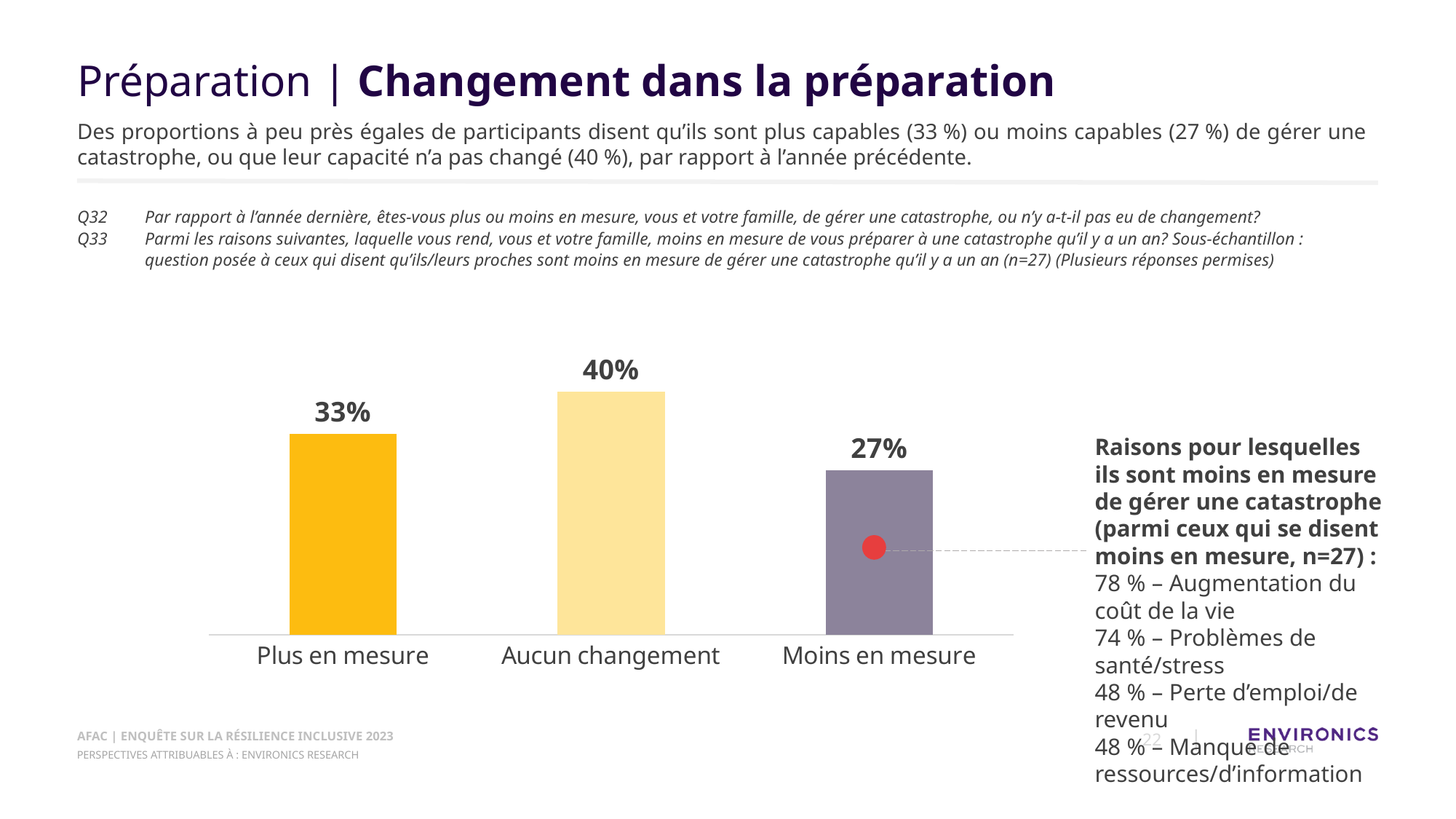
What colour is the bar for "Moins en mesure"? Purple/grey What kind of chart is shown on the slide? Bar chart What is the value for "Moins en mesure"? 27% Which category has the highest value? Aucun changement What is the difference between "Plus en mesure" and "Moins en mesure"? 6% Which is larger, "Plus en mesure" or "Moins en mesure"? Plus en mesure How many categories are shown in the chart? 3 What is the value for "Aucun changement"? 40% Which category has the lowest value? Moins en mesure What is the difference between "Aucun changement" and "Moins en mesure"? 13% Which bar has a red dot connected to the text box on the right? Moins en mesure What is the value for "Plus en mesure"? 33%